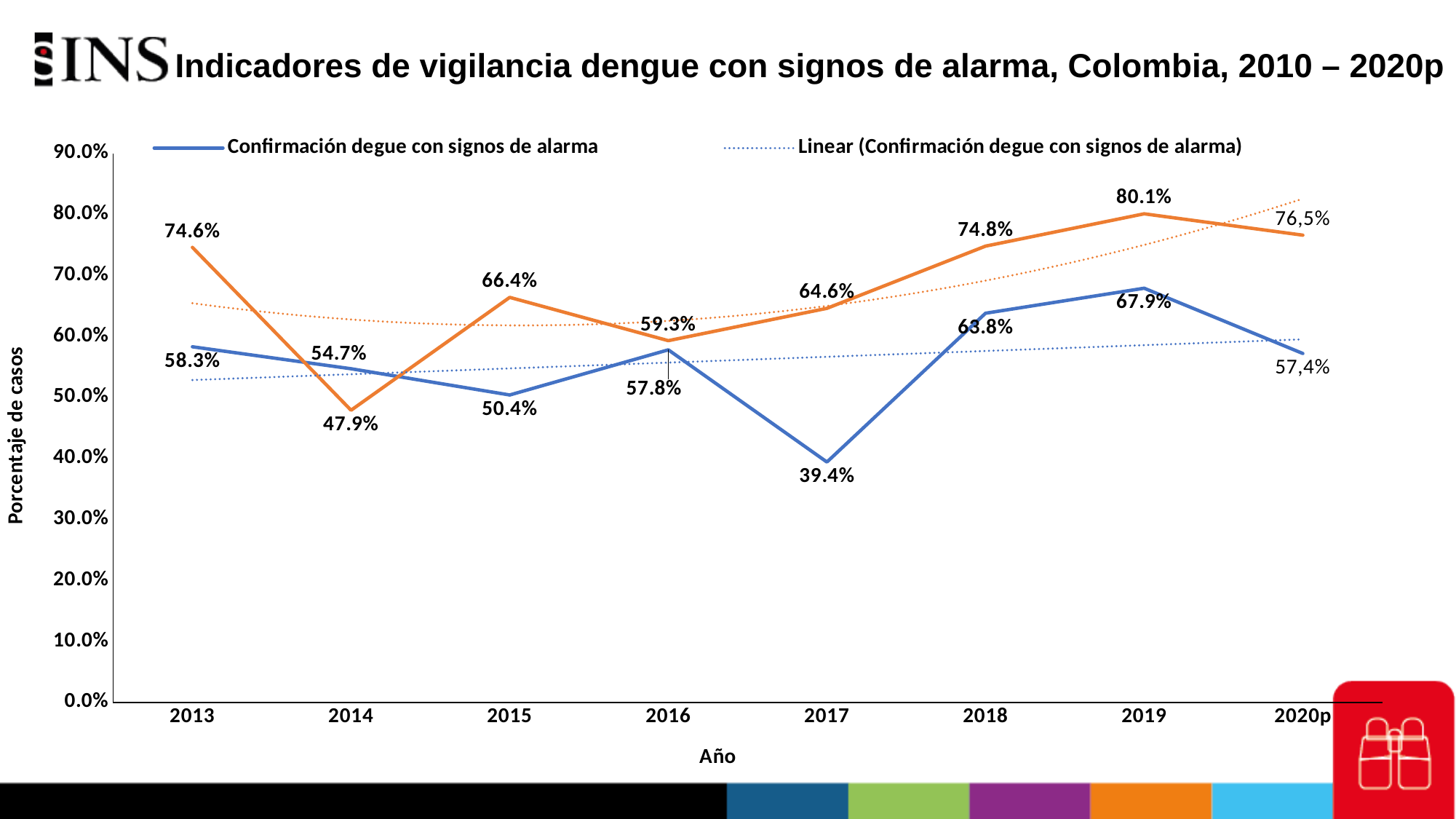
In 2014, which is higher: the orange line or the Confirmación degue con signos de alarma line? Confirmación degue con signos de alarma What is the value of the Confirmación degue con signos de alarma line in 2017? 39.4% What is the difference between the orange line and the Confirmación degue con signos de alarma line in 2013? 16.3 percentage points Does the Confirmación degue con signos de alarma line rise or fall from 2017 to 2019? Rise What is the value of the Confirmación degue con signos de alarma line in 2020p? 57,4% In which year is the Confirmación degue con signos de alarma line at its lowest? 2017 What type of chart is shown on the slide? Line chart In which year does the orange line reach its highest value? 2019 How many entries does the legend list? 2 What is the value of the orange line in 2019? 80.1% In which year does the Confirmación degue con signos de alarma line reach its highest value? 2019 How many years are shown on the x axis? 8